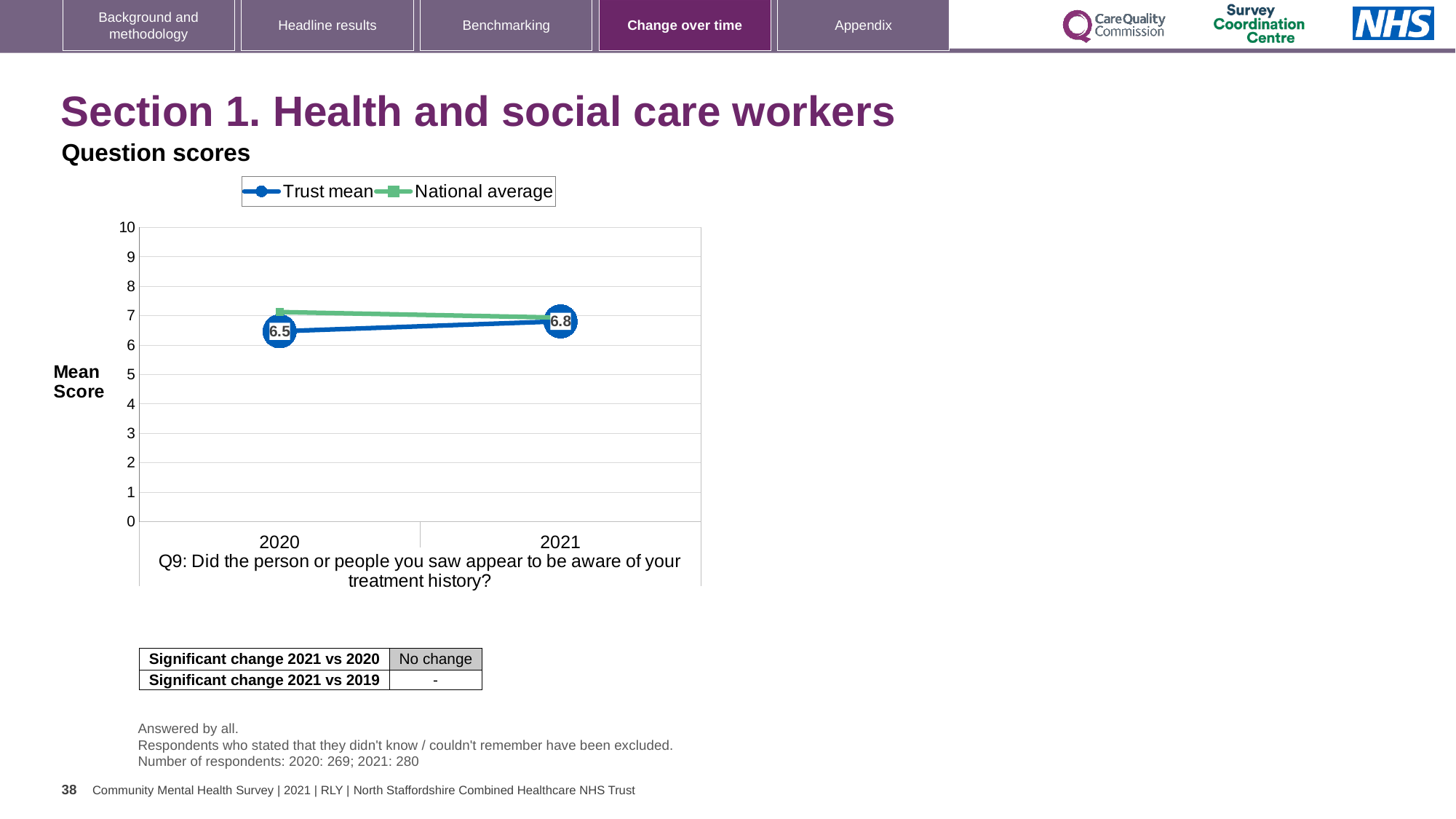
Is the National average value for 2021 greater or less than 8? less What type of chart is shown? line chart How many series does the legend list? 2 Is the National average value for 2020 greater or less than 6? greater What is the Trust mean score for 2021? 6.8 What is the Trust mean score for 2020? 6.5 Does the Trust mean rise or fall from 2020 to 2021? rise How many years are plotted on the x axis? 2 In 2020, which series is higher, Trust mean or National average? National average What is the label on the y axis of the chart? Mean Score By how much did the Trust mean score change from 2020 to 2021? 0.3 Which year has the higher Trust mean score, 2020 or 2021? 2021